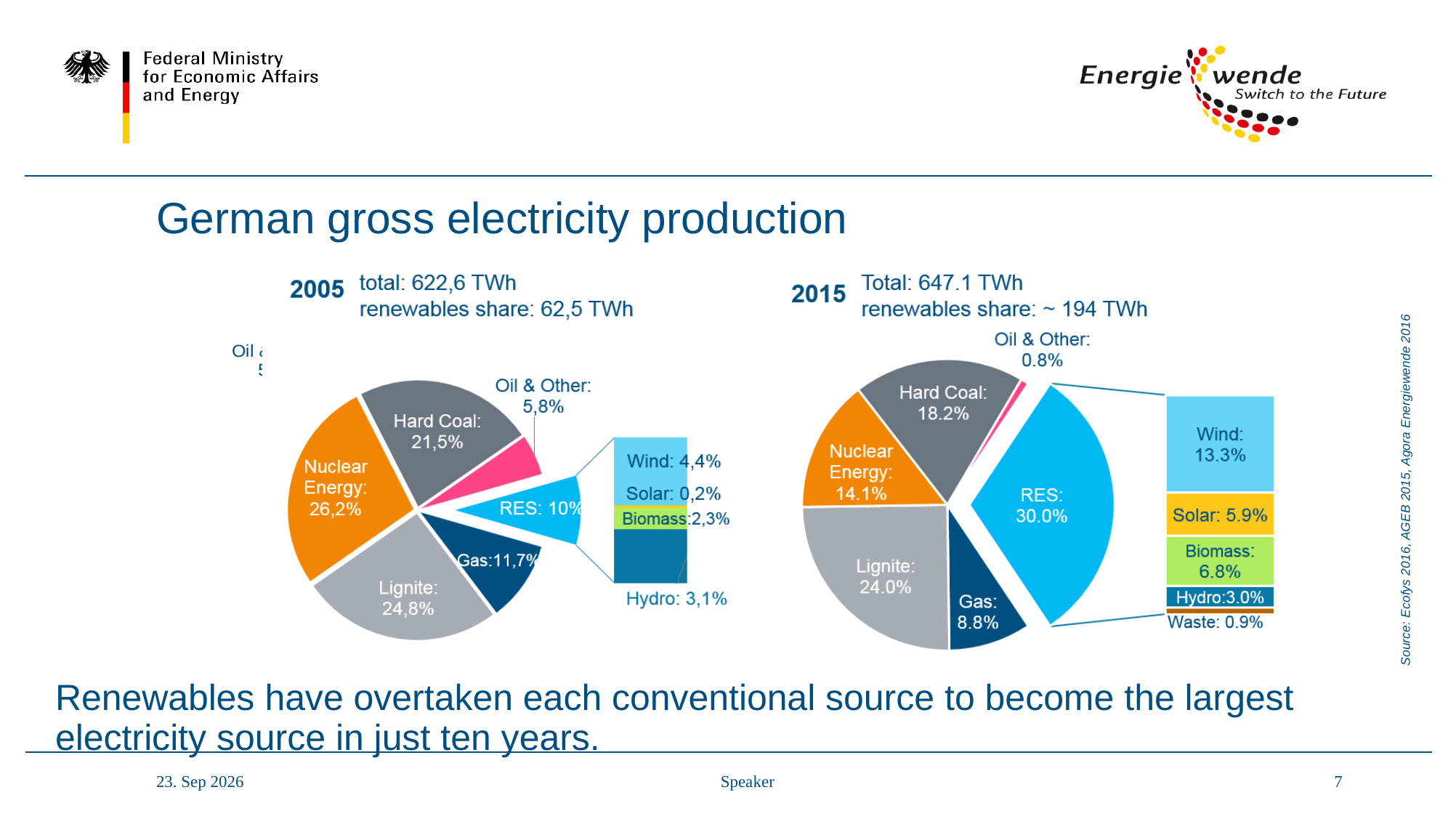
In the 2015 renewables breakdown, what is the share of Wind? 13.3% In the 2015 pie chart, what is the share of Lignite? 24.0% In the 2015 chart, what is the difference between the Hard Coal share and the Gas share? 9.4% What total gross electricity production is stated for 2015? 647.1 TWh In the 2015 pie chart, what share does RES have? 30.0% In the 2005 pie chart, which source has the largest share? Nuclear Energy In the 2005 chart, which is larger: the share of Hard Coal or the share of Lignite? Lignite In the 2015 pie chart, which source has the largest share? RES In the 2015 pie chart, which source has the smallest share? Oil & Other What kind of chart is used to show the 2015 electricity production mix? Pie chart In the 2005 pie chart, what share does Nuclear Energy have? 26,2% In the 2005 renewables breakdown, what is the share of Solar? 0,2%